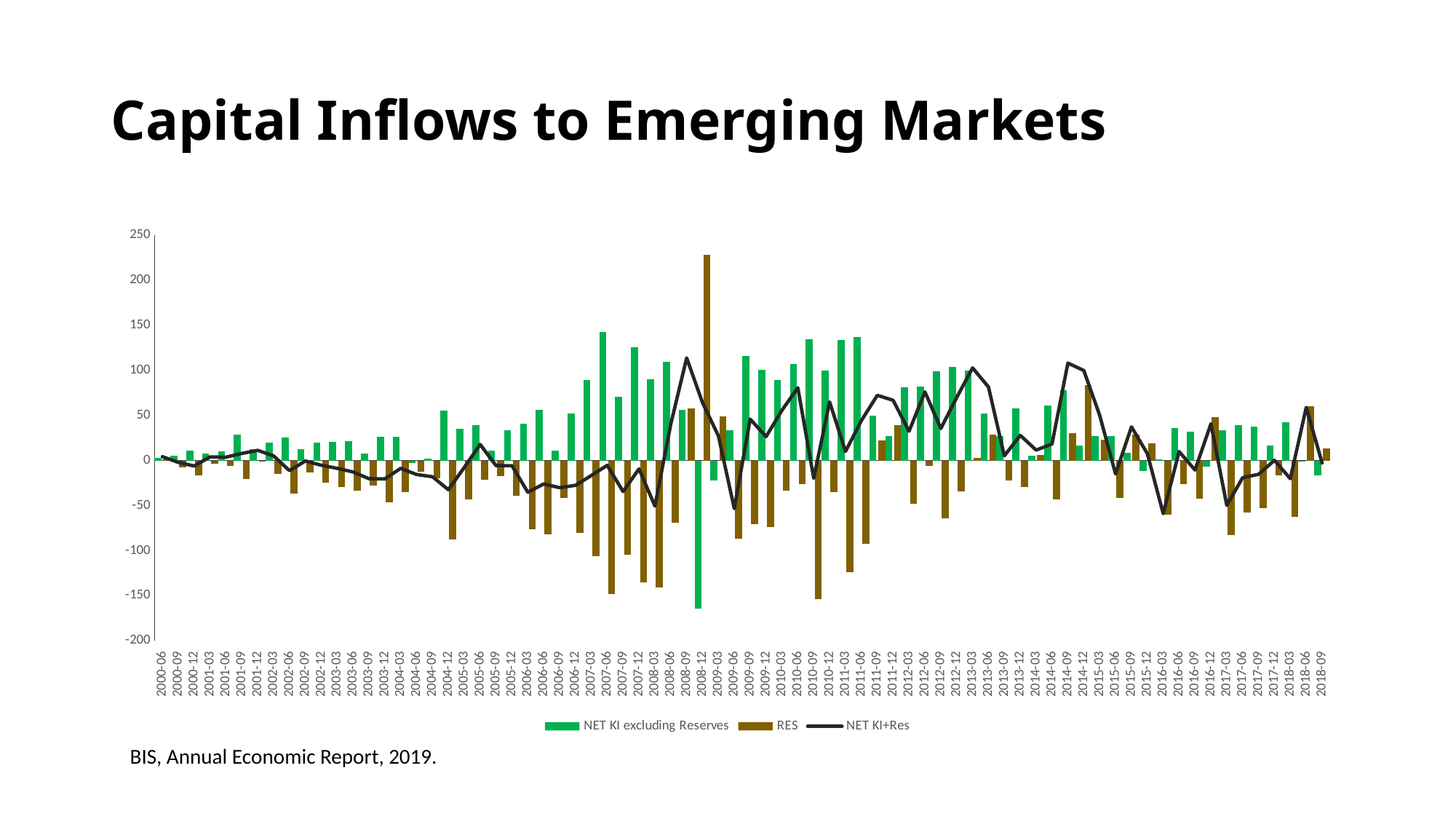
What are the three series named in the legend? NET KI excluding Reserves, RES, NET KI+Res In which quarter does the NET KI excluding Reserves series reach its lowest value? 2008-12 What kind of chart is shown on the slide? A combined bar and line chart What is the title of the chart on the slide? Capital Inflows to Emerging Markets How many series does the legend list? 3 Is the RES value for 2008-12 greater or less than 200? greater Is the NET KI excluding Reserves value for 2008-12 greater or less than -150? less Is the RES value for 2010-09 greater or less than -100? less Which is larger for NET KI excluding Reserves: the value in 2007-06 or the value in 2000-06? 2007-06 In which quarter does the RES series reach its highest value? 2008-12 Which is larger in 2008-12: the RES value or the NET KI excluding Reserves value? RES